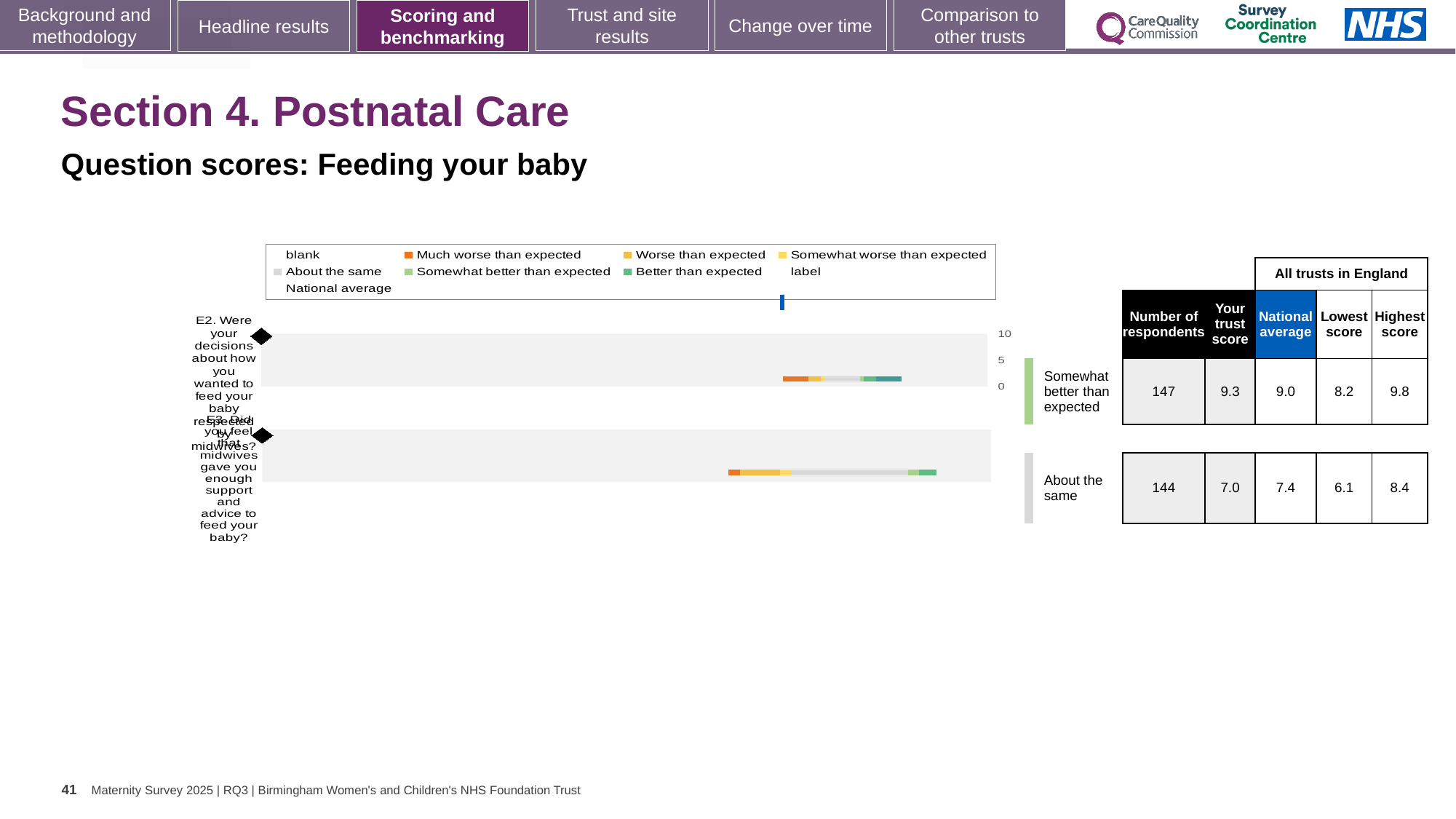
What benchmark category is shown for question E2? Somewhat better than expected What is the highest score across all trusts in England for question E2? 9.8 How many respondents answered question E3? 144 Which question has the higher trust score, E2 or E3? E2 What is the difference between the trust score and the national average for question E3? 0.4 What is the lowest score across all trusts in England for question E3? 6.1 What is the national average for question E2? 9.0 How many questions (categories) are plotted in the chart? 2 What is the trust score for question E2 (decisions about how you wanted to feed your baby respected by midwives)? 9.3 What kind of chart is shown on the slide? bar chart What is the national average for question E3? 7.4 What is the trust score for question E3 (midwives gave you enough support and advice to feed your baby)? 7.0